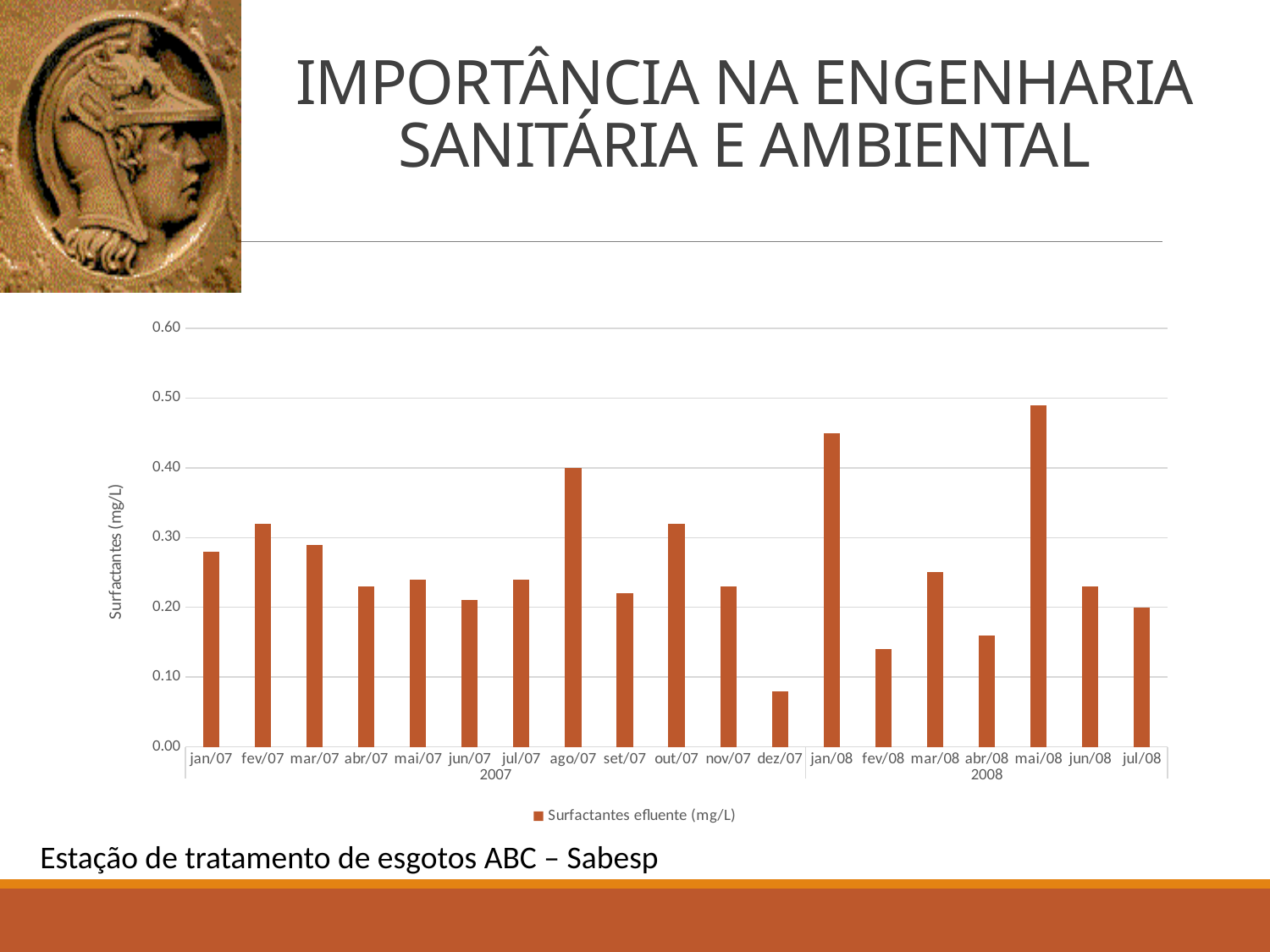
What is the legend entry for the series? Surfactantes efluente (mg/L) What kind of chart is shown on the slide? bar chart What is the label on the vertical axis? Surfactantes (mg/L) What is the value for ago/07? 0.40 How many series does the legend list? 1 Is the value for dez/07 greater or less than 0.10? less Which is larger, the value for jan/08 or the value for fev/08? jan/08 Is the value for jan/08 greater or less than 0.40? greater How many months (bars) are plotted in the chart? 19 Which month has the lowest surfactant value? dez/07 Which month has the highest surfactant value? mai/08